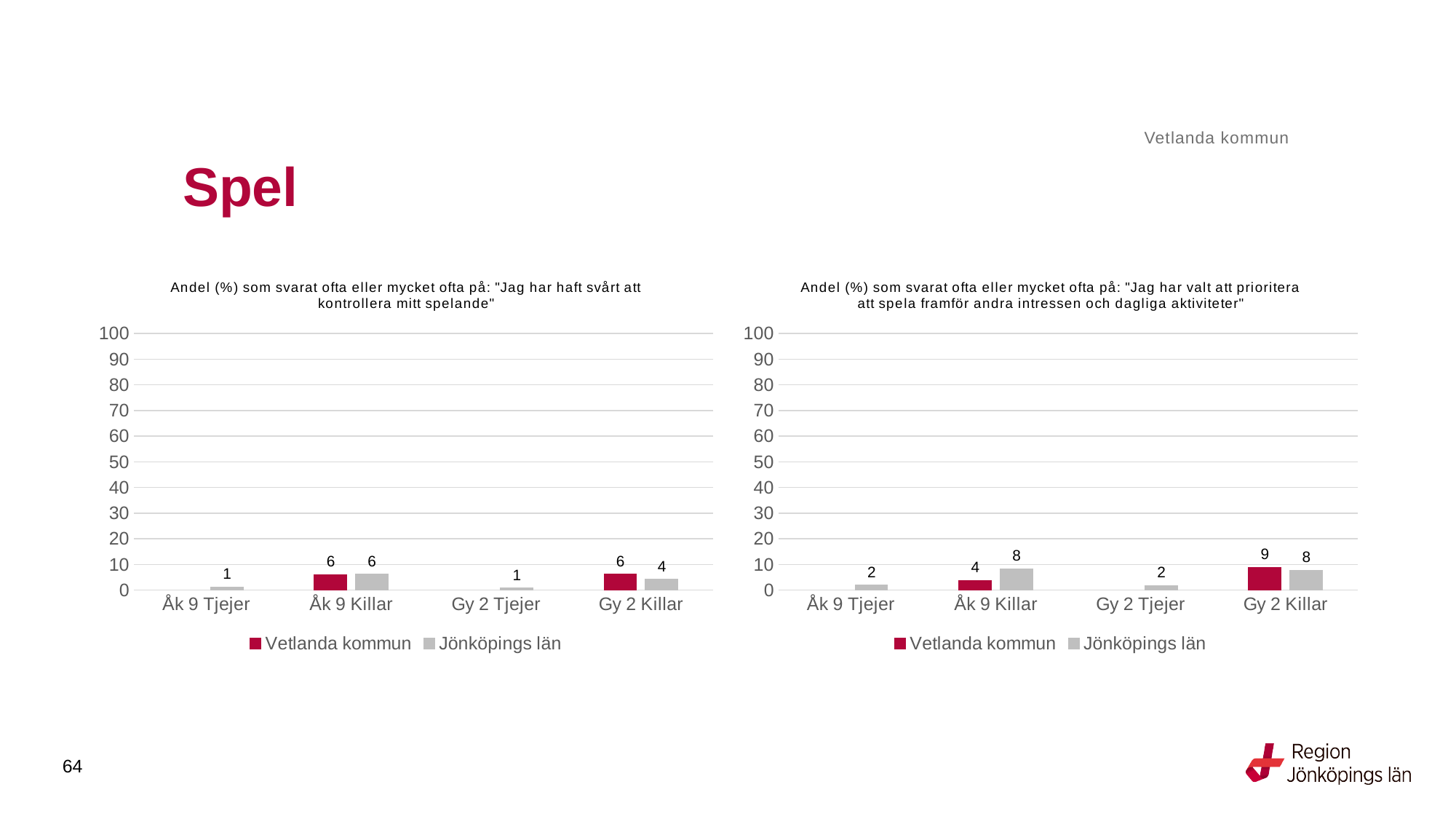
In the right chart, which is larger for Gy 2 Killar, Vetlanda kommun or Jönköpings län? Vetlanda kommun In the right chart, what is the value for Jönköpings län for Åk 9 Killar? 8 How many categories are shown on the x axis of the left chart? 4 How many series does the legend of the right chart list? 2 What kind of chart is the left chart? Bar chart In the left chart, what is the difference between Vetlanda kommun and Jönköpings län for Gy 2 Killar? 2 In the right chart, what is the difference between Jönköpings län and Vetlanda kommun for Åk 9 Killar? 4 In the left chart, what is the value for Vetlanda kommun for Åk 9 Killar? 6 In the left chart, what is the value for Jönköpings län for Gy 2 Killar? 4 In the right chart, what is the value for Vetlanda kommun for Gy 2 Killar? 9 In the left chart, what is the value for Jönköpings län for Åk 9 Tjejer? 1 In the right chart, which category has the highest value for Jönköpings län? Åk 9 Killar and Gy 2 Killar (tied at 8)